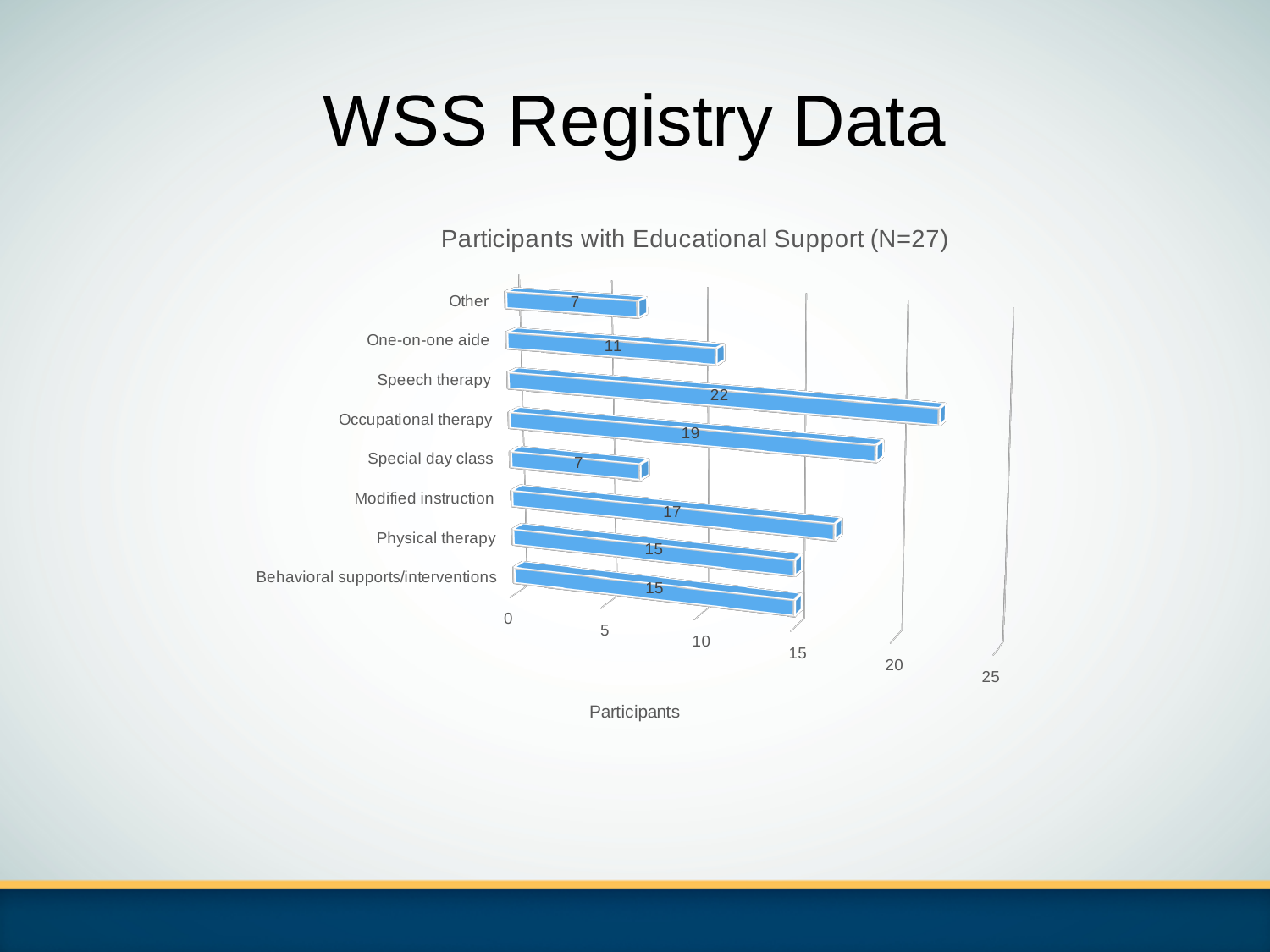
Which category has the highest value? Speech therapy What is the value for Occupational therapy? 19 What is the label of the horizontal axis? Participants What is the value for One-on-one aide? 11 What kind of chart is this? Bar chart What is the title of the chart? Participants with Educational Support (N=27) What is the value for Speech therapy? 22 Which is larger, Modified instruction or Physical therapy? Modified instruction How many categories are shown in the chart? 8 Is the value for Occupational therapy greater or less than 15? greater What is the difference between Speech therapy and Occupational therapy? 3 What is the value for Modified instruction? 17